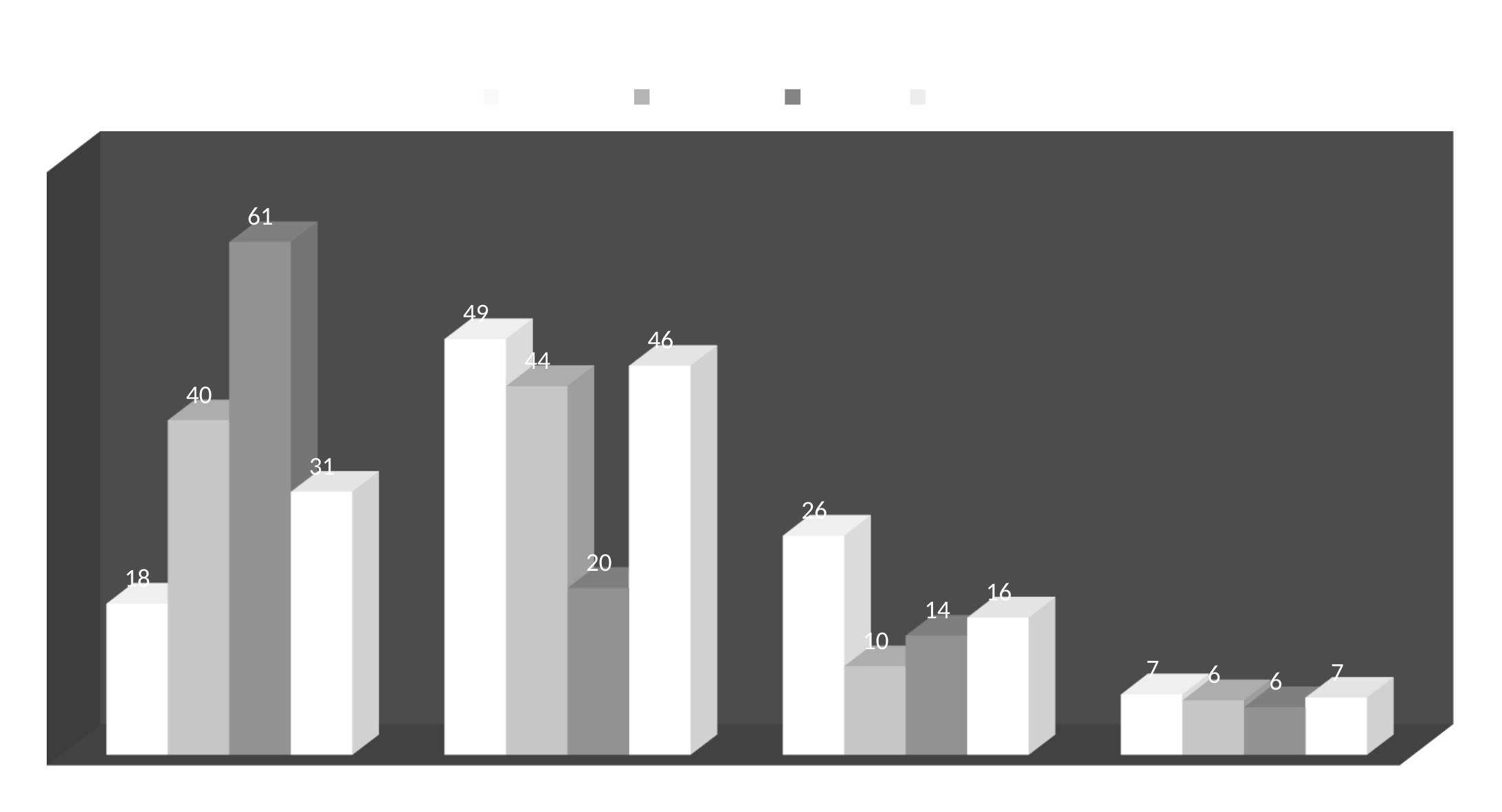
What kind of chart is shown on the slide? bar chart What is the value of the third bar in the second group from the left? 20 How many colour swatches does the legend above the chart show? 4 In the leftmost group, what is the difference between the tallest bar and the shortest bar? 43 How many groups of bars does the chart show? 4 What is the value of the first bar in the third group from the left? 26 What is the highest value labelled on the chart? 61 What is the value of the second bar in the leftmost group? 40 What is the lowest value labelled on the chart? 6 In the second group from the left, which is taller: the first bar or the fourth bar? the first bar (49) Does the chart display a title? No Do the values of the third (darkest) bar in each group rise or fall from left to right across the groups? fall